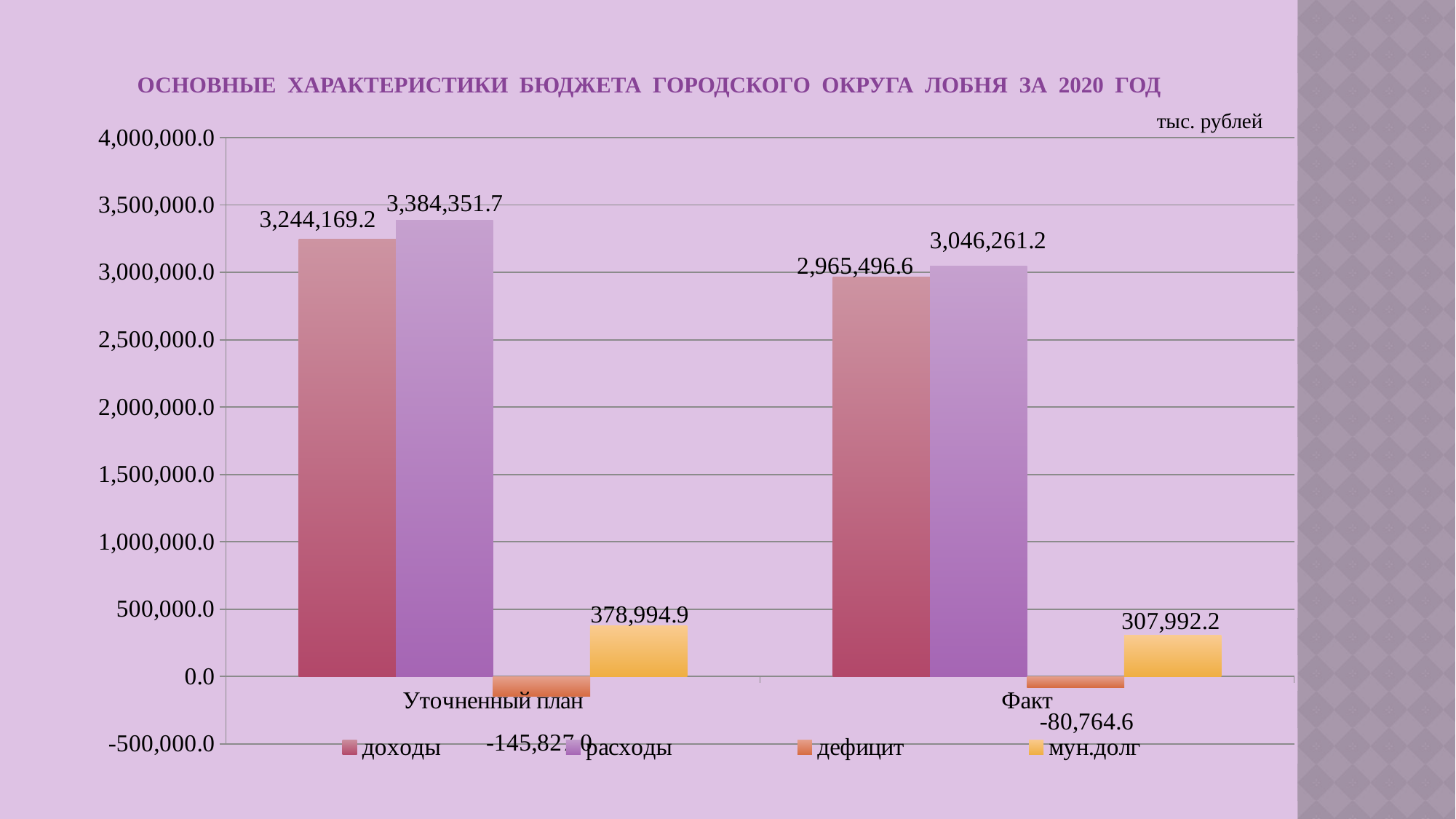
What is the value of расходы for Факт? 3,046,261.2 How many series does the legend list? 4 How many categories are shown on the x axis? 2 Is the value of доходы for Факт greater or less than 3,000,000.0? less What is the value of дефицит for Факт? -80,764.6 What is the difference between расходы and доходы for Факт? 80,764.6 Which series has the highest value in the Уточненный план category? расходы What is the value of доходы for Уточненный план? 3,244,169.2 What type of chart is shown on the slide? bar chart What is the value of мун.долг for Уточненный план? 378,994.9 What unit is stated above the chart? тыс. рублей Which series has the lowest value in the Факт category? дефицит